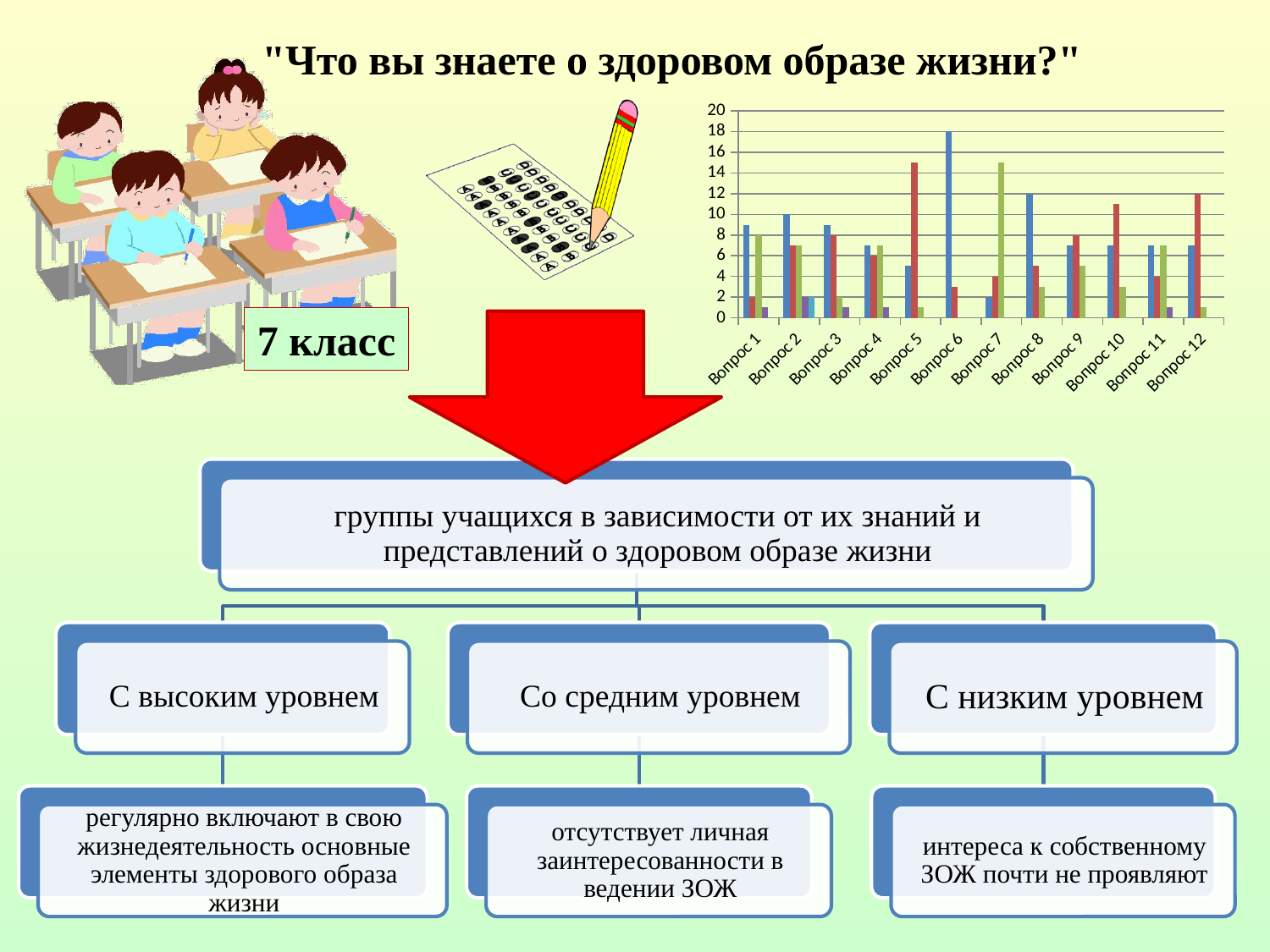
Which category contains the tallest bar in the chart? Вопрос 6 Is the green bar for Вопрос 7 greater or less than 14? greater Which is larger: the blue bar for Вопрос 6 or the red bar for Вопрос 5? the blue bar for Вопрос 6 How many question categories (Вопрос) are shown on the x axis of the chart? 12 What is the difference between the blue bar for Вопрос 6 and the blue bar for Вопрос 8? 6 What is the value of the blue bar for Вопрос 6? 18 What is the highest value shown on the chart's vertical axis? 20 What is the value of the blue bar for Вопрос 2? 10 What is the value of the blue bar for Вопрос 8? 12 Is the blue bar for Вопрос 5 greater or less than 6? less Is the red bar for Вопрос 5 greater or less than 14? greater What kind of chart is shown on the slide? bar chart